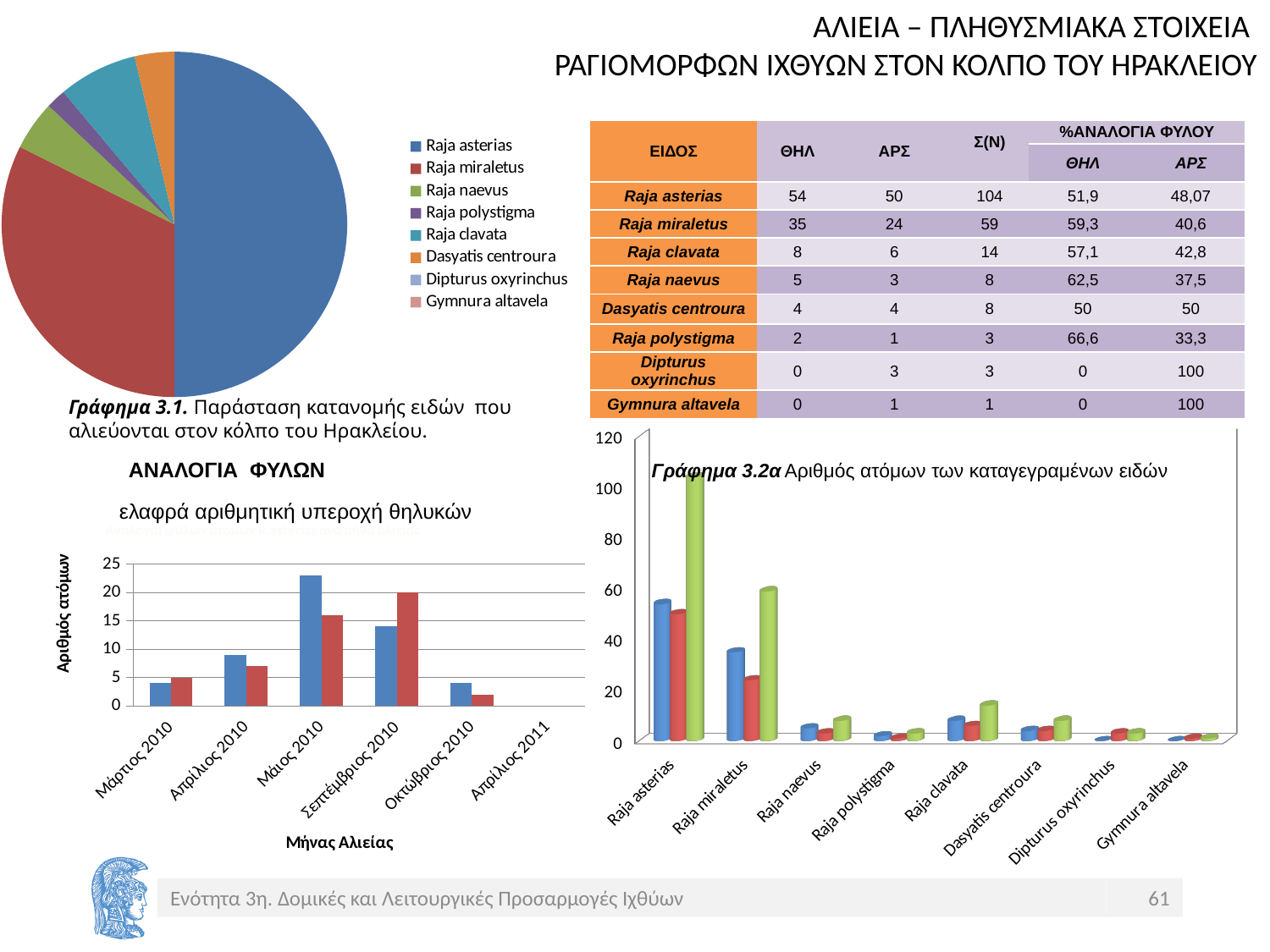
In the ΑΝΑΛΟΓΙΑ ΦΥΛΩΝ chart at the bottom left, is the blue bar for Μάιος 2010 greater or less than 20? greater How many species does the legend of the pie chart (Γράφημα 3.1) list? 8 What is the label of the x axis of the ΑΝΑΛΟΓΙΑ ΦΥΛΩΝ chart at the bottom left? Μήνας Αλιείας In the pie chart (Γράφημα 3.1), which species has the largest slice? Raja asterias What kind of chart is Γράφημα 3.1 at the top left of the slide? pie chart In the pie chart (Γράφημα 3.1), which slice is larger: Raja miraletus or Raja naevus? Raja miraletus In the ΑΝΑΛΟΓΙΑ ΦΥΛΩΝ chart at the bottom left, which month has the tallest blue bar? Μάιος 2010 In Γράφημα 3.2α at the bottom right, is the green bar for Raja asterias greater or less than 100? greater How many species are shown on the x axis of Γράφημα 3.2α at the bottom right? 8 What kind of chart is the ΑΝΑΛΟΓΙΑ ΦΥΛΩΝ chart at the bottom left of the slide? bar chart How many months are shown on the x axis of the ΑΝΑΛΟΓΙΑ ΦΥΛΩΝ chart at the bottom left? 6 In the ΑΝΑΛΟΓΙΑ ΦΥΛΩΝ chart at the bottom left, is the blue bar for Μάρτιος 2010 greater or less than 5? less